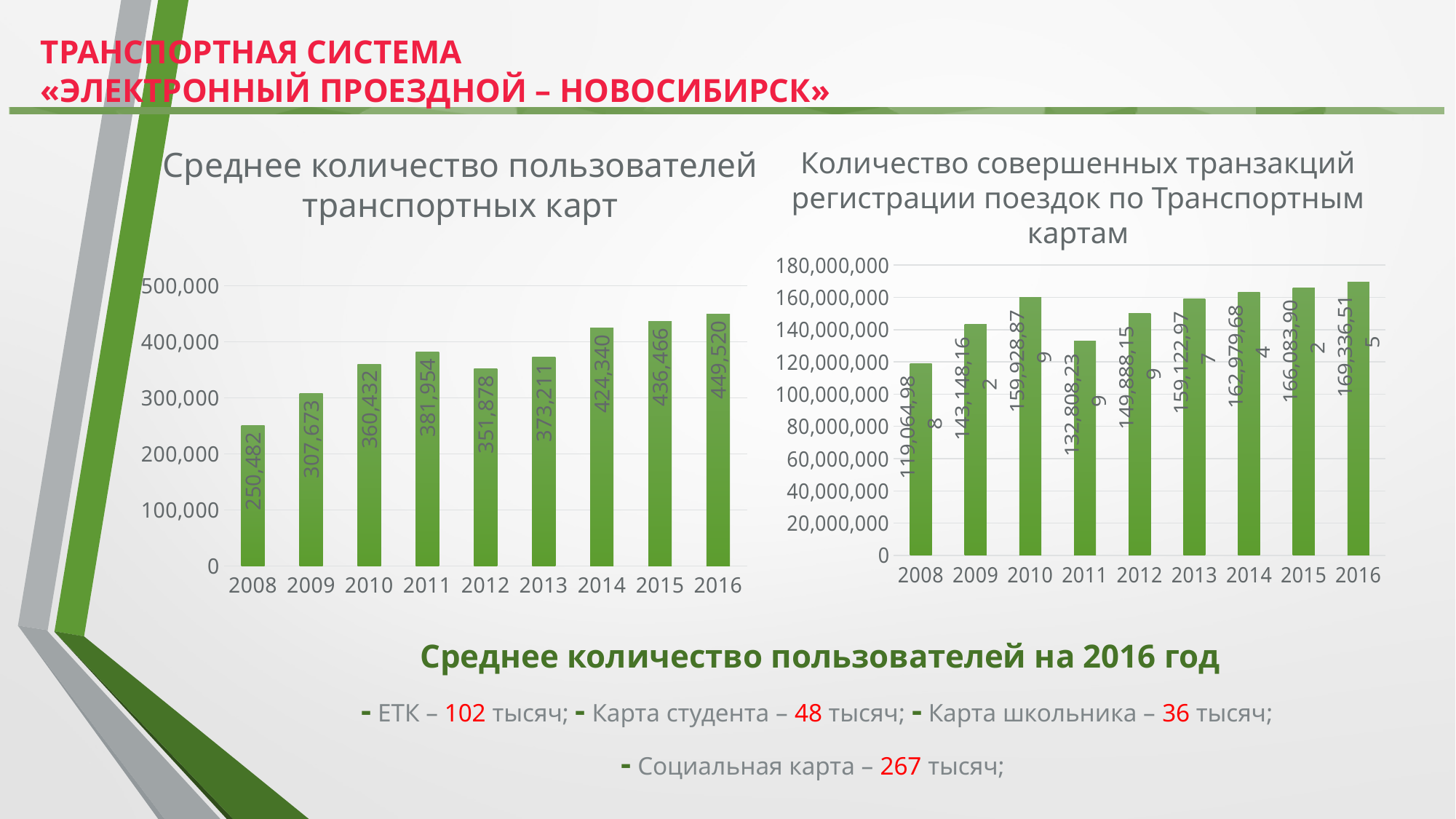
In the left chart (Среднее количество пользователей транспортных карт), which year has the highest value? 2016 In the right chart (Количество совершенных транзакций регистрации поездок по Транспортным картам), which year has the lowest value? 2008 In the left chart (Среднее количество пользователей транспортных карт), what is the difference between the values for 2016 and 2015? 13,054 In the right chart (Количество совершенных транзакций регистрации поездок по Транспортным картам), which is larger, the value for 2010 or the value for 2011? 2010 In the left chart (Среднее количество пользователей транспортных карт), how many years are shown on the x axis? 9 In the left chart (Среднее количество пользователей транспортных карт), what is the value for 2016? 449,520 In the left chart (Среднее количество пользователей транспортных карт), what is the value for 2012? 351,878 In the right chart (Количество совершенных транзакций регистрации поездок по Транспортным картам), is the value for 2008 greater or less than 120,000,000? less In the left chart (Среднее количество пользователей транспортных карт), which is larger, the value for 2011 or the value for 2012? 2011 In the left chart (Среднее количество пользователей транспортных карт), which year has the lowest value? 2008 In the left chart (Среднее количество пользователей транспортных карт), what is the value for 2008? 250,482 What kind of chart is the right chart (Количество совершенных транзакций регистрации поездок по Транспортным картам)? bar chart